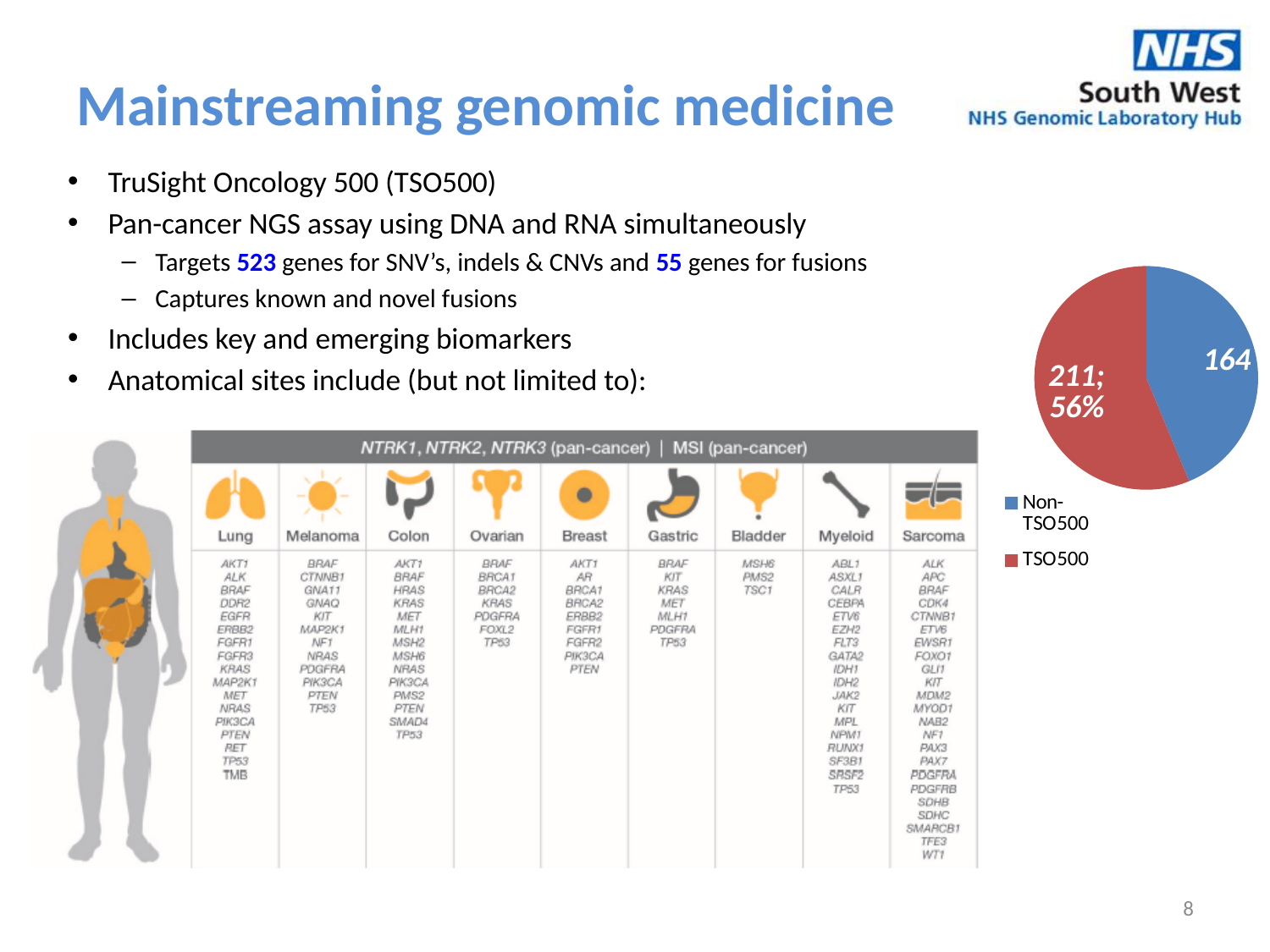
What is the total of the two values shown in the pie chart? 375 Which category has the smaller slice in the pie chart? Non-TSO500 What colour is the TSO500 slice in the pie chart? red What percentage share of the pie chart does the TSO500 slice represent? 56% What kind of chart is shown on the right of the slide? pie chart Which category has the larger slice in the pie chart? TSO500 What is the difference between the TSO500 value and the Non-TSO500 value in the pie chart? 47 Is the value for TSO500 larger or smaller than the value for Non-TSO500? larger What value is shown for the Non-TSO500 slice of the pie chart? 164 How many entries does the pie chart legend list? 2 How many slices does the pie chart have? 2 What value is shown for the TSO500 slice of the pie chart? 211